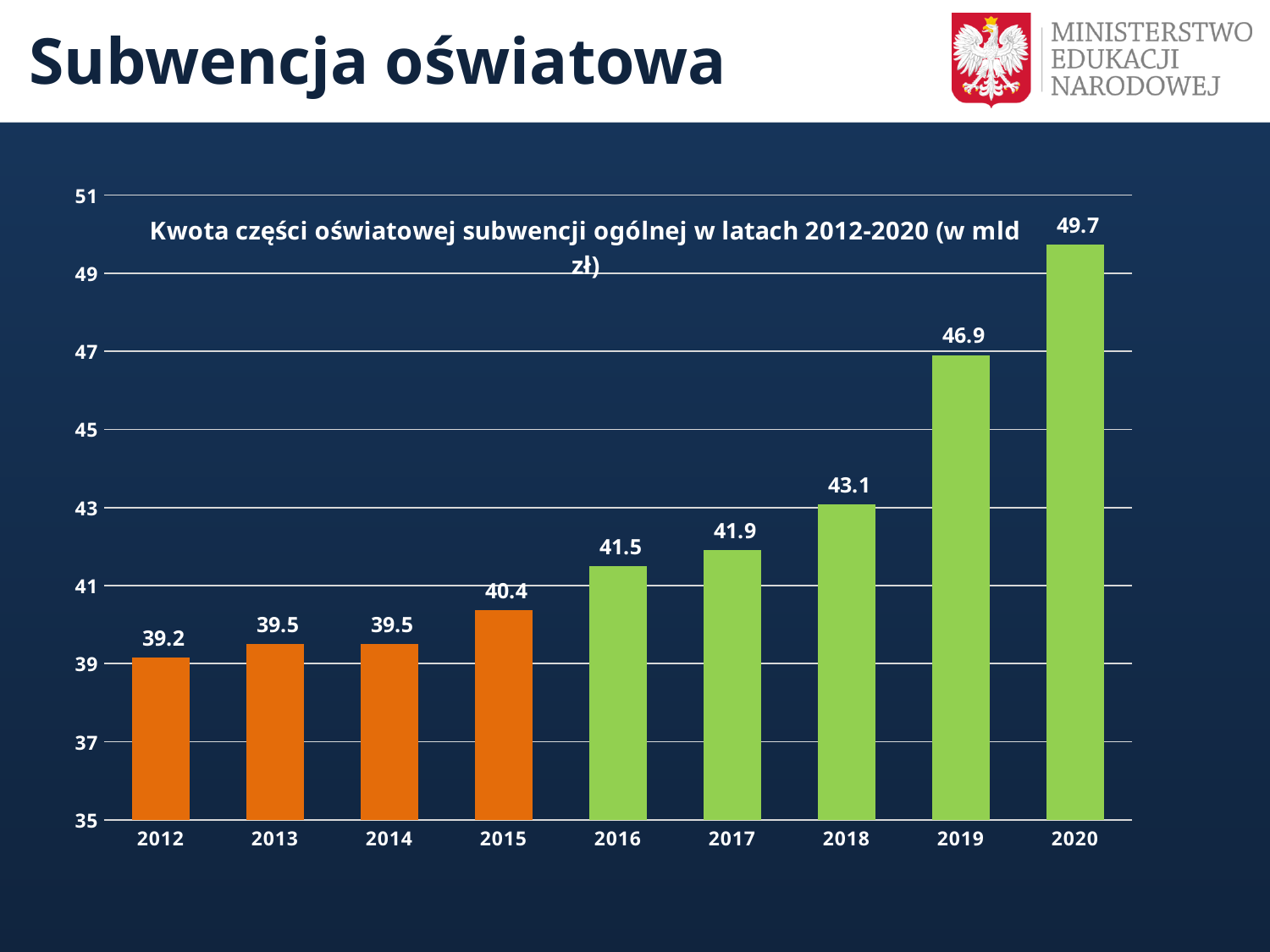
Do the values rise or fall from 2012 to 2020? rise What is the value for 2018? 43.1 What is the difference between the values for 2019 and 2018? 3.8 Which year has the highest value? 2020 What is the value for 2012? 39.2 Is the value for 2019 greater or less than 45? greater What kind of chart is shown on the slide? bar chart Which year has the lowest value? 2012 What is the difference between the values for 2020 and 2012? 10.5 What is the value for 2020? 49.7 Which is larger, the value for 2016 or the value for 2015? 2016 How many years are shown on the x axis? 9